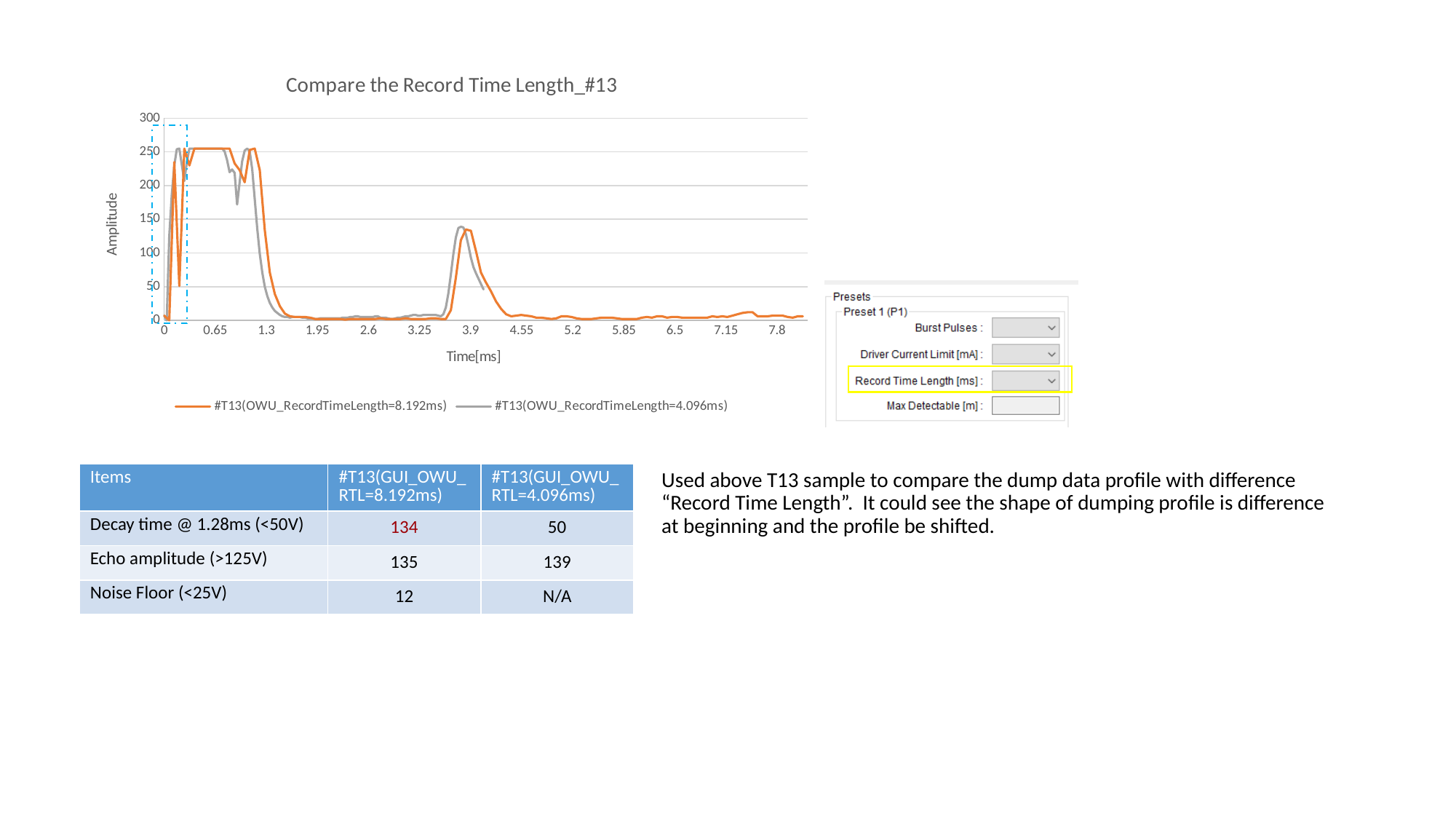
What is the label of the vertical axis of the chart? Amplitude Is the value of the #T13(OWU_RecordTimeLength=8.192ms) series at 5.2 ms greater or less than 50? less Which series extends further along the Time[ms] axis, #T13(OWU_RecordTimeLength=8.192ms) or #T13(OWU_RecordTimeLength=4.096ms)? #T13(OWU_RecordTimeLength=8.192ms) Is the peak of the #T13(OWU_RecordTimeLength=8.192ms) series near 3.9 ms greater or less than 100? greater What kind of chart is shown on the slide? Line chart What is the title of the chart? Compare the Record Time Length_#13 Is the peak of the #T13(OWU_RecordTimeLength=4.096ms) series near 3.9 ms greater or less than 150? less How many series does the legend of the chart list? 2 How many tick labels are shown on the Time[ms] axis of the chart? 13 Between 1.3 ms and 1.95 ms, do the values of the #T13(OWU_RecordTimeLength=8.192ms) series rise or fall? fall